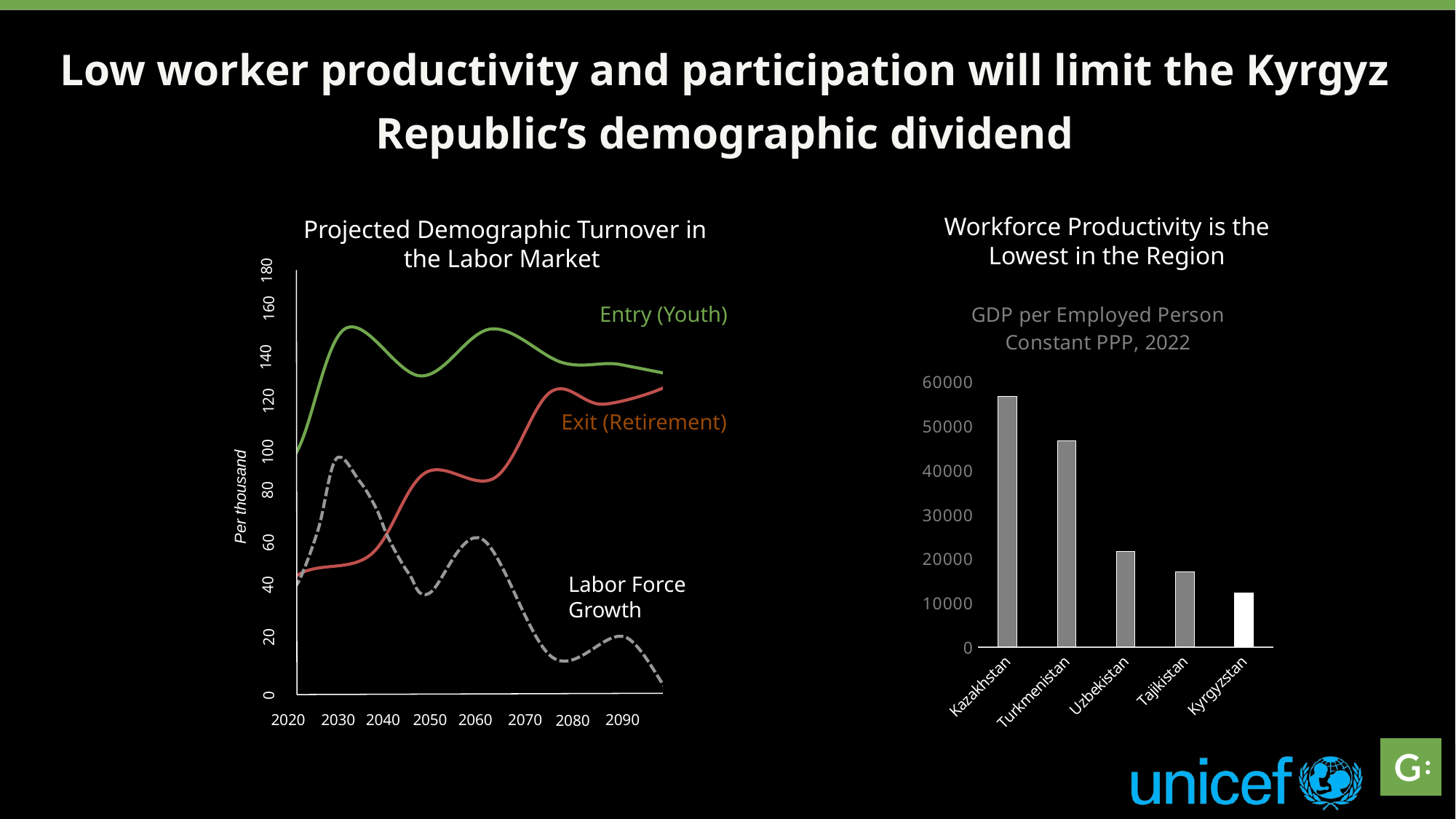
In the chart titled 'Workforce Productivity is the Lowest in the Region', is the value for Kyrgyzstan greater or less than 10000? greater In the chart titled 'Workforce Productivity is the Lowest in the Region', is the value for Kazakhstan greater or less than 50000? greater What kind of chart is the one titled 'Projected Demographic Turnover in the Labor Market'? Line chart In the chart titled 'Projected Demographic Turnover in the Labor Market', what is the label of the y axis? Per thousand How many series are plotted in the chart titled 'Projected Demographic Turnover in the Labor Market'? 3 In the chart titled 'Workforce Productivity is the Lowest in the Region', which country has the highest GDP per employed person? Kazakhstan In the chart titled 'Workforce Productivity is the Lowest in the Region', which is larger, the value for Turkmenistan or the value for Tajikistan? Turkmenistan What kind of chart is the one titled 'Workforce Productivity is the Lowest in the Region'? Bar chart In the chart titled 'Projected Demographic Turnover in the Labor Market', does the Exit (Retirement) line generally rise or fall from 2020 to 2090? Rise How many countries are shown in the chart titled 'Workforce Productivity is the Lowest in the Region'? 5 In the chart titled 'Workforce Productivity is the Lowest in the Region', which country has the lowest GDP per employed person? Kyrgyzstan In the chart titled 'Workforce Productivity is the Lowest in the Region', is the value for Uzbekistan greater or less than 30000? less